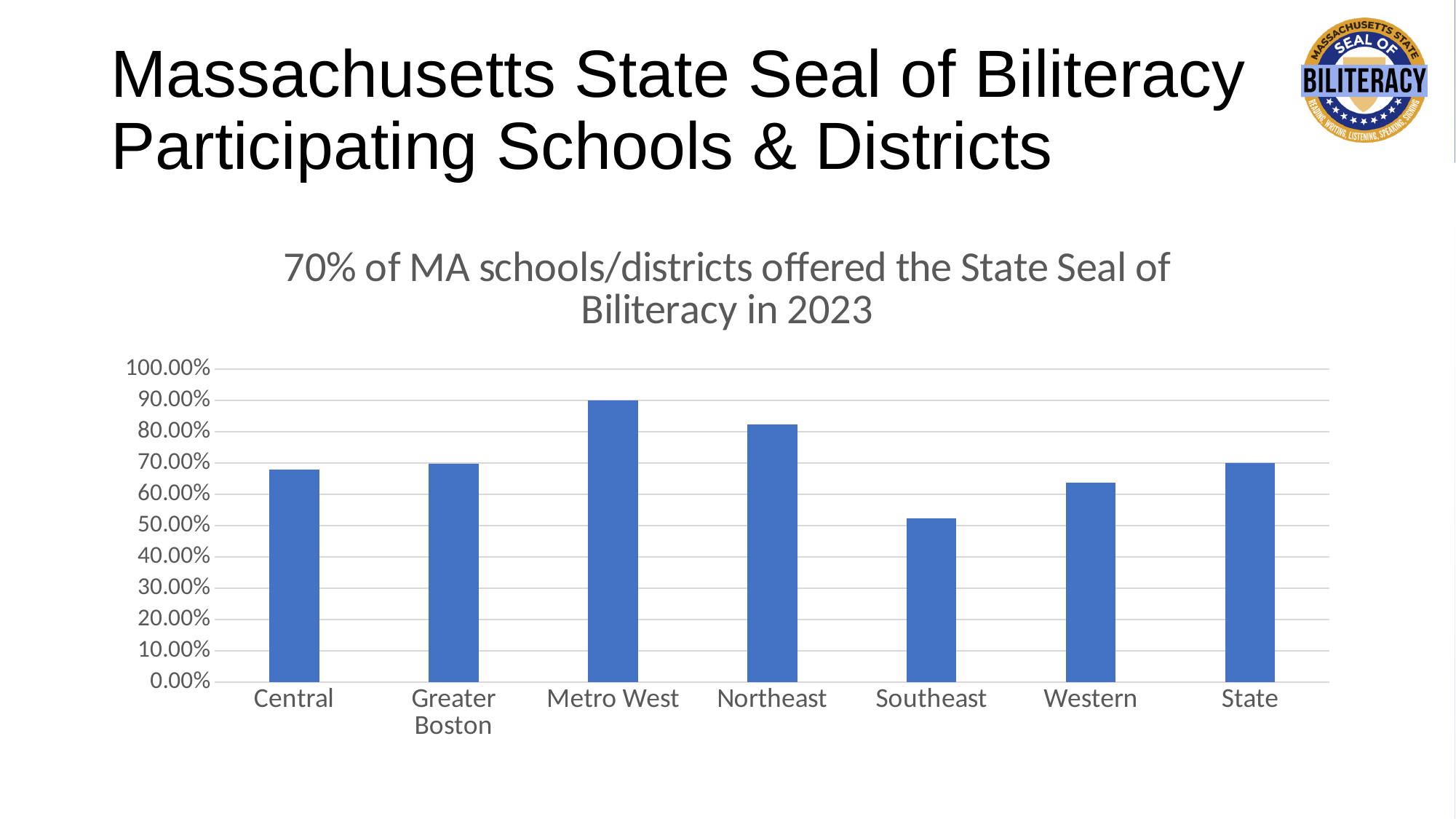
Which is larger, the value for Western or the value for Northeast? Northeast What kind of chart is shown on the slide? bar chart Is the value for Southeast greater or less than 60.00%? less How many categories are shown on the x axis of the chart? 7 What is the title of the chart? 70% of MA schools/districts offered the State Seal of Biliteracy in 2023 Which region has the lowest bar in the chart? Southeast Which region has the highest bar in the chart? Metro West Is the value for Central greater or less than 60.00%? greater Is the value for Metro West greater or less than 80.00%? greater Which is larger, the value for Southeast or the value for Central? Central Which is larger, the value for Metro West or the value for Northeast? Metro West